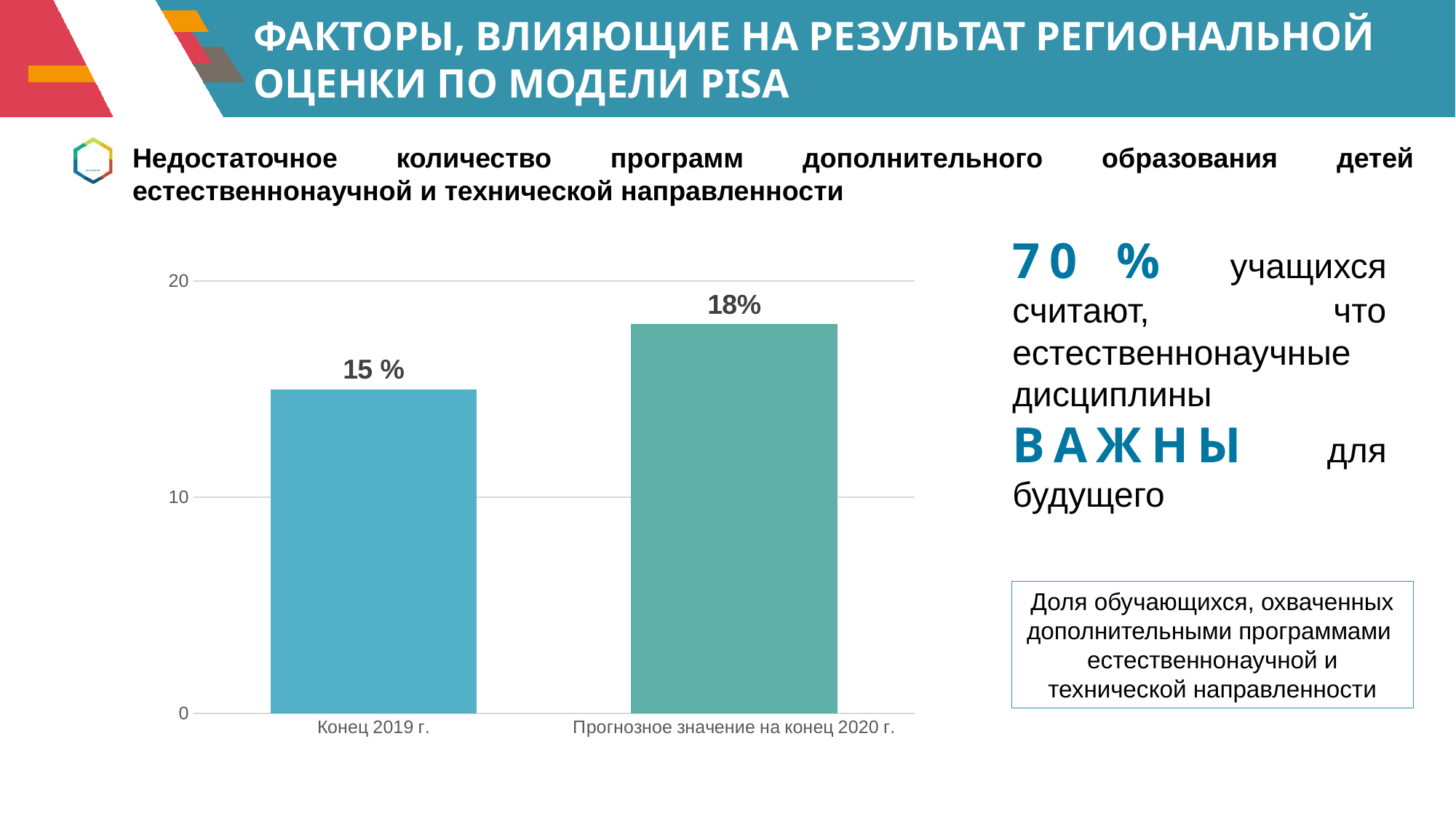
Is the value for "Конец 2019 г." greater or less than 10? greater Which category has the lowest value? Конец 2019 г. What is the value for "Прогнозное значение на конец 2020 г."? 18% Is the value for "Прогнозное значение на конец 2020 г." greater or less than 20? less Which category has the highest value? Прогнозное значение на конец 2020 г. Which is larger: the value for "Конец 2019 г." or the value for "Прогнозное значение на конец 2020 г."? Прогнозное значение на конец 2020 г. Do the values rise or fall from "Конец 2019 г." to "Прогнозное значение на конец 2020 г."? rise What kind of chart is shown on the slide? bar chart What is the value for "Конец 2019 г."? 15 % What is the highest tick value shown on the vertical axis of the chart? 20 What is the difference between the value for "Прогнозное значение на конец 2020 г." and the value for "Конец 2019 г."? 3% How many categories are shown on the chart? 2